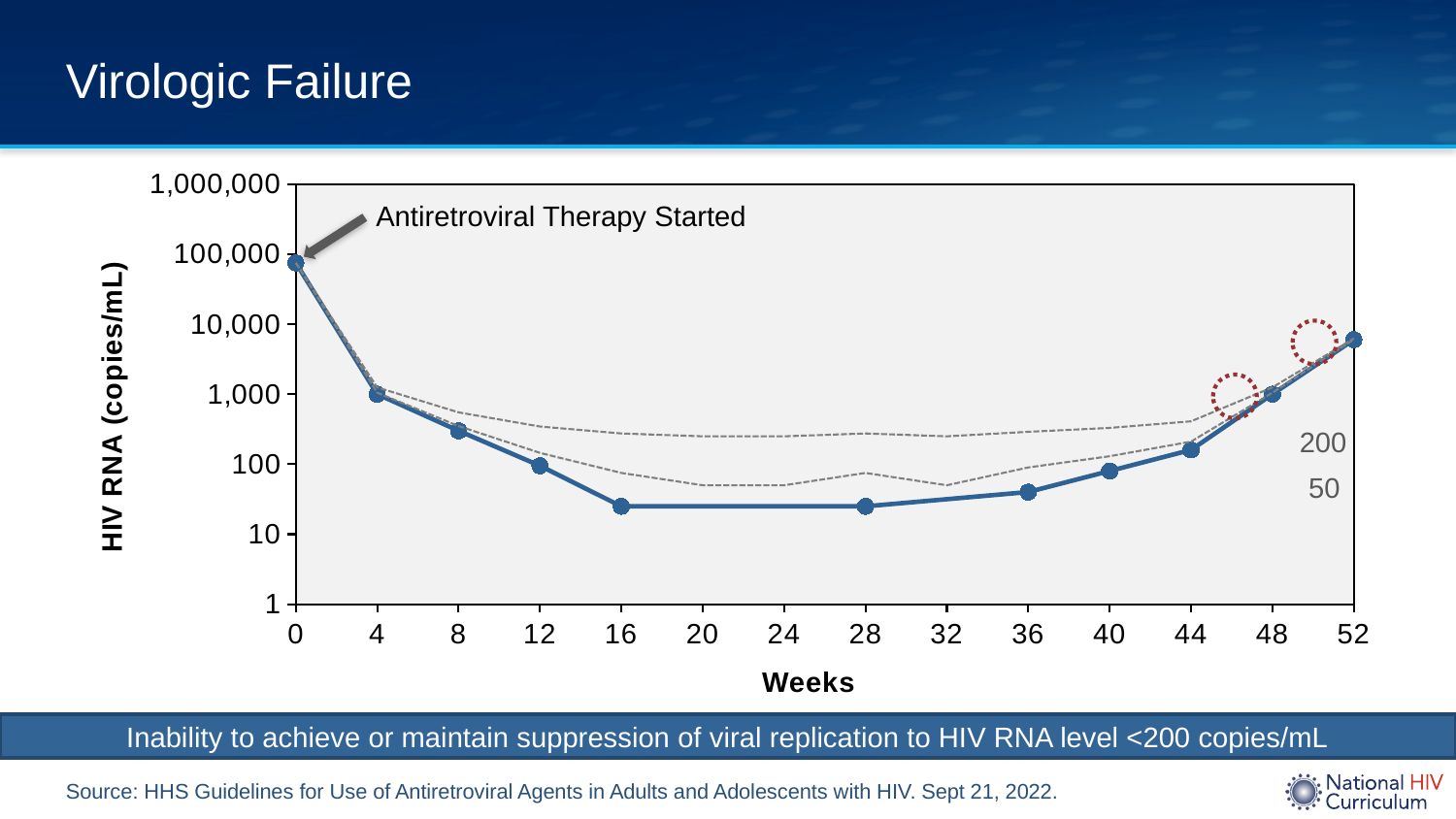
Is the HIV RNA value at week 52 greater or less than 1,000? greater What is the HIV RNA value at week 48 on the solid line? 1,000 Is the HIV RNA value at week 8 greater or less than 100? greater Does the HIV RNA value on the solid line rise or fall between week 16 and week 52? rise Which has the larger HIV RNA value on the solid line, week 44 or week 52? week 52 How many data points are marked on the solid line? 11 What is the label of the y axis? HIV RNA (copies/mL) What is the HIV RNA value at week 4 on the solid line? 1,000 Is the HIV RNA value at week 16 greater or less than 100? less What kind of chart is shown on the slide? line chart At which week is the HIV RNA value on the solid line highest? 0